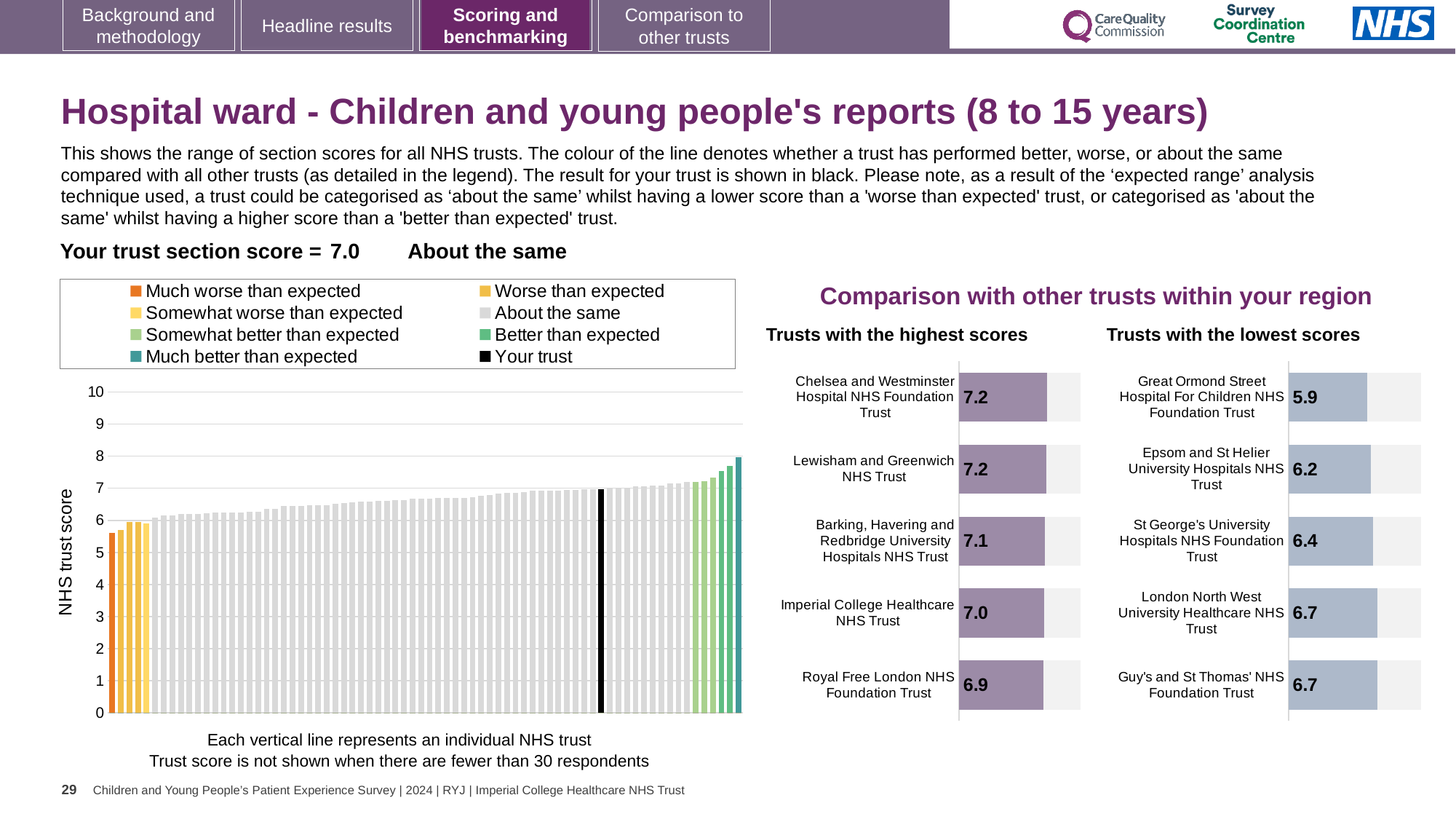
In the 'Trusts with the lowest scores' chart, which trust has the lowest score? Great Ormond Street Hospital For Children NHS Foundation Trust What kind of chart is the large chart on the left with the y axis labelled 'NHS trust score'? bar chart In the 'Trusts with the highest scores' chart, which trust has the lowest score? Royal Free London NHS Foundation Trust In the 'NHS trust score' chart, is the value of the tallest bar greater or less than 7? greater In the 'Trusts with the lowest scores' chart, what is the difference between the scores of Guy's and St Thomas' NHS Foundation Trust and Great Ormond Street Hospital For Children NHS Foundation Trust? 0.8 How many entries does the legend above the 'NHS trust score' chart list? 8 In the 'NHS trust score' chart, is the value of the shortest bar greater or less than 6? less In the 'Trusts with the highest scores' chart, what is the difference between the scores of Chelsea and Westminster Hospital NHS Foundation Trust and Royal Free London NHS Foundation Trust? 0.3 In the 'Trusts with the lowest scores' chart, what is the score for Epsom and St Helier University Hospitals NHS Trust? 6.2 In the 'Trusts with the highest scores' chart, what is the score for Barking, Havering and Redbridge University Hospitals NHS Trust? 7.1 In the 'NHS trust score' chart, is the value of the black bar (your trust) greater or less than 8? less In the 'Trusts with the lowest scores' chart, how many trusts are shown? 5